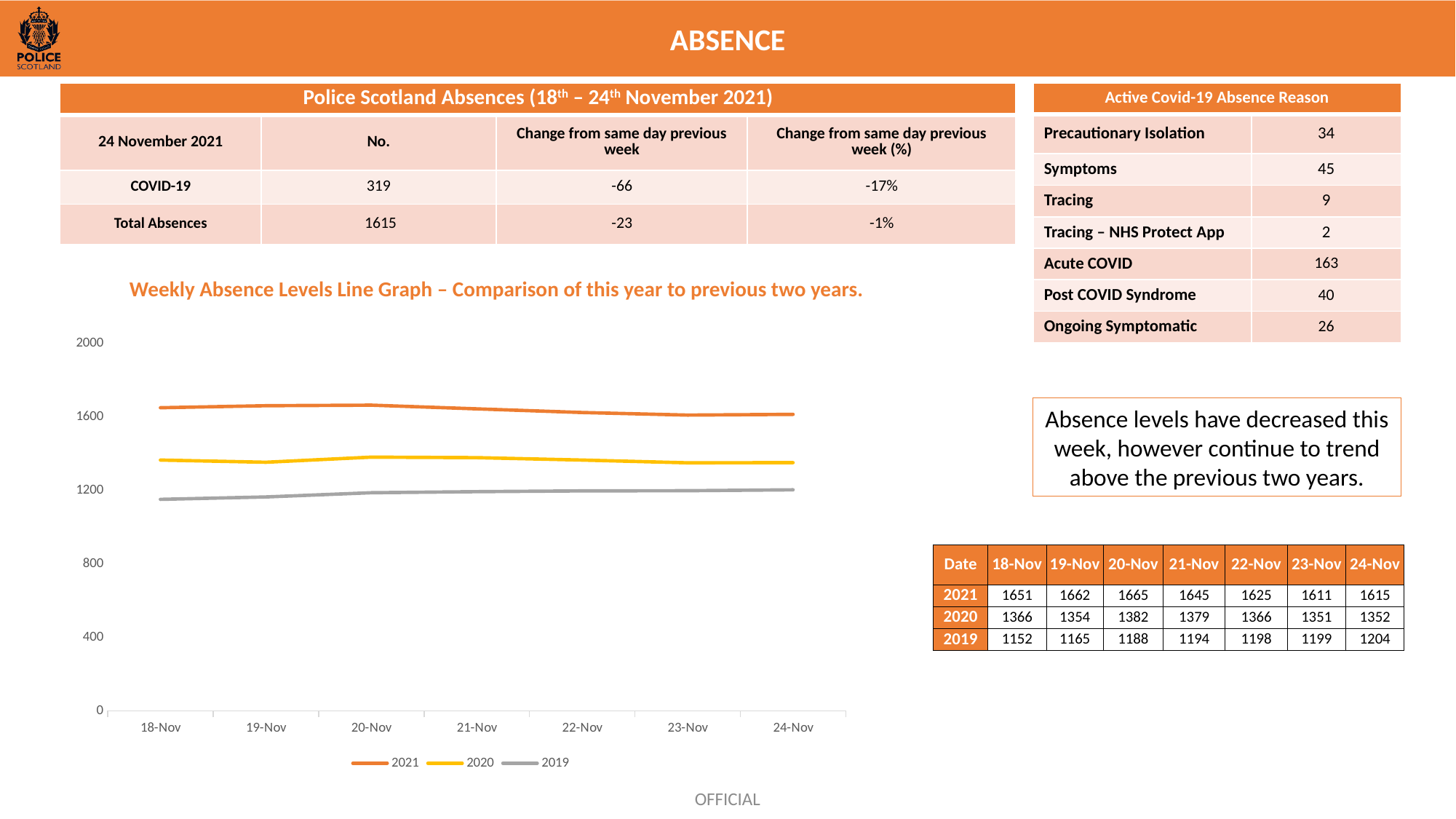
In the Weekly Absence Levels line graph, is the 2020 value or the 2019 value larger on 21-Nov? 2020 In the Weekly Absence Levels line graph, does the 2019 line rise or fall from 18-Nov to 24-Nov? rise Is the 2021 value on 18-Nov in the Weekly Absence Levels line graph greater or less than 1600? greater What colour is the 2020 line in the Weekly Absence Levels line graph? yellow Is the 2020 value on 24-Nov in the Weekly Absence Levels line graph greater or less than 1600? less Which series has the lowest values throughout the Weekly Absence Levels line graph? 2019 How many dates are plotted along the x axis of the Weekly Absence Levels line graph? 7 What is the title of the line graph on the slide? Weekly Absence Levels Line Graph – Comparison of this year to previous two years. Which series has the highest values throughout the Weekly Absence Levels line graph? 2021 How many series does the legend of the Weekly Absence Levels line graph list? 3 What kind of chart is the Weekly Absence Levels graph? line chart Is the 2019 value on 18-Nov in the Weekly Absence Levels line graph greater or less than 1200? less